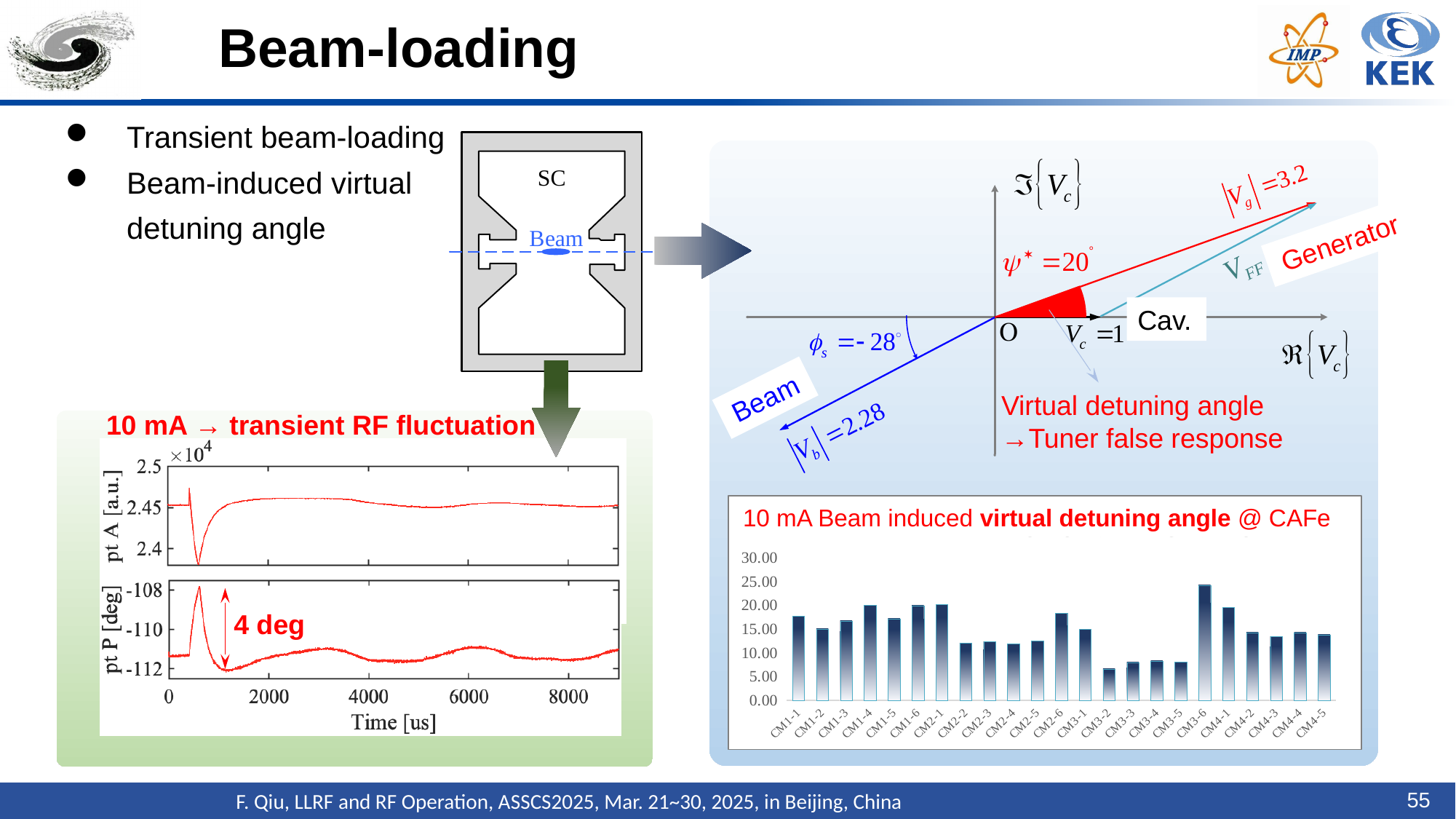
In the '10 mA Beam induced virtual detuning angle @ CAFe' chart, which is larger, the value for CM3-6 or the value for CM4-1? CM3-6 In the '10 mA Beam induced virtual detuning angle @ CAFe' chart, is the value for CM3-6 greater or less than 20.00? greater In the '10 mA Beam induced virtual detuning angle @ CAFe' chart, is the value for CM2-2 greater or less than 15.00? less In the '10 mA Beam induced virtual detuning angle @ CAFe' chart, which cavity has the highest virtual detuning angle? CM3-6 What kind of chart is the '10 mA Beam induced virtual detuning angle @ CAFe' chart? bar chart In the '10 mA Beam induced virtual detuning angle @ CAFe' chart, is the value for CM1-4 greater or less than 15.00? greater In the '10 mA Beam induced virtual detuning angle @ CAFe' chart, which cavity has the lowest virtual detuning angle? CM3-2 In the '10 mA Beam induced virtual detuning angle @ CAFe' chart, what is the highest tick value shown on the vertical axis? 30.00 In the '10 mA Beam induced virtual detuning angle @ CAFe' chart, which is larger, the value for CM1-1 or the value for CM3-2? CM1-1 In the '10 mA Beam induced virtual detuning angle @ CAFe' chart, how many cavities (categories) are plotted? 23 What is the x-axis label of the two time-series plots in the lower-left panel of the slide? Time [us]